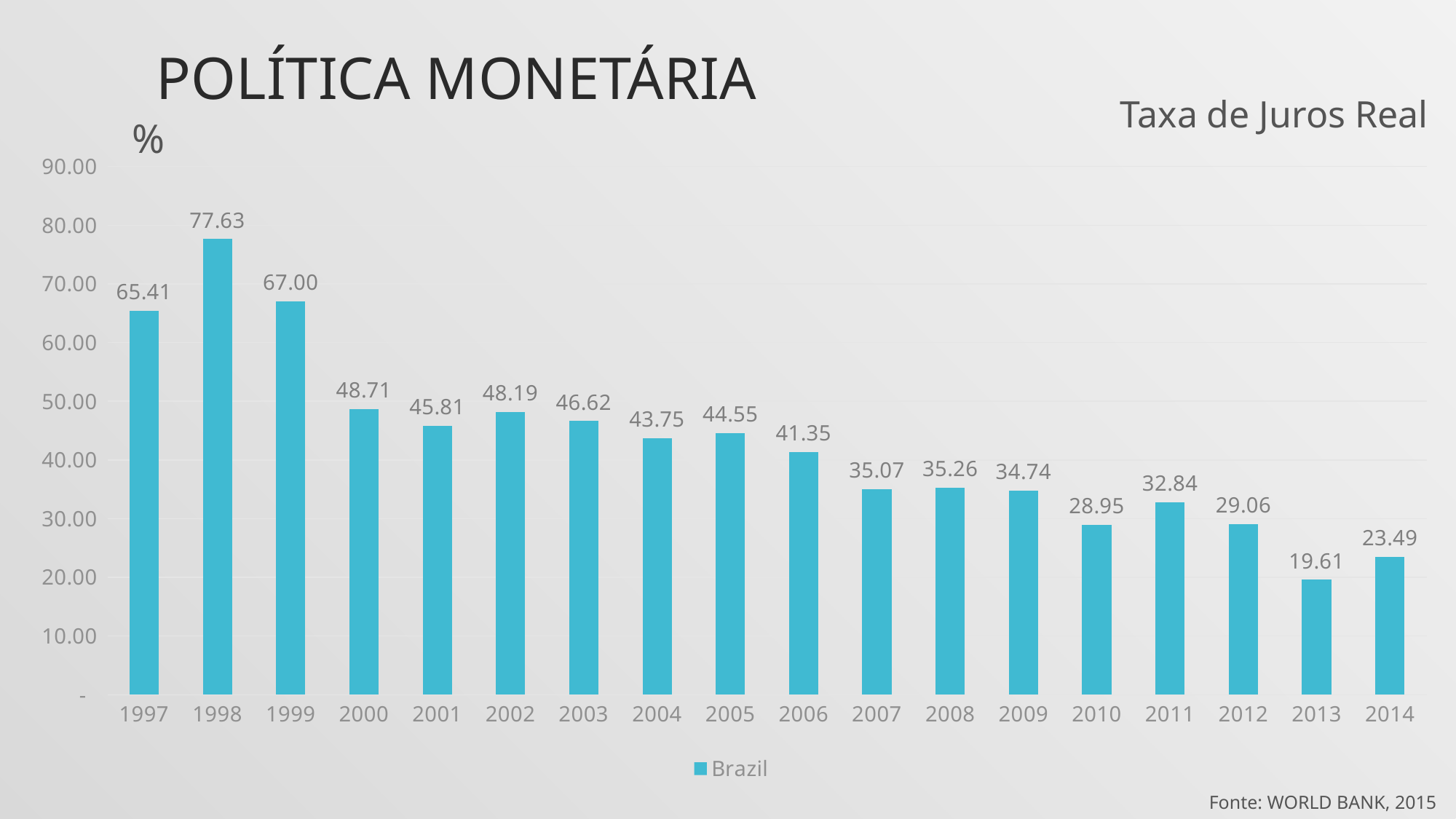
What kind of chart is shown on the slide? Bar chart Which year has the highest value? 1998 What is the difference between the values for 1998 and 1999? 10.63 What is the value shown for 2006? 41.35 How many series does the legend list? 1 Do the values generally rise or fall from 1998 to 2013? Fall How many years are shown on the x axis? 18 What is the value shown for 2014? 23.49 What is the real interest rate value shown for 1998? 77.63 Which year has the lowest value? 2013 Which year has the larger value, 2000 or 2002? 2000 Is the value for 2011 greater or less than 30.00? greater